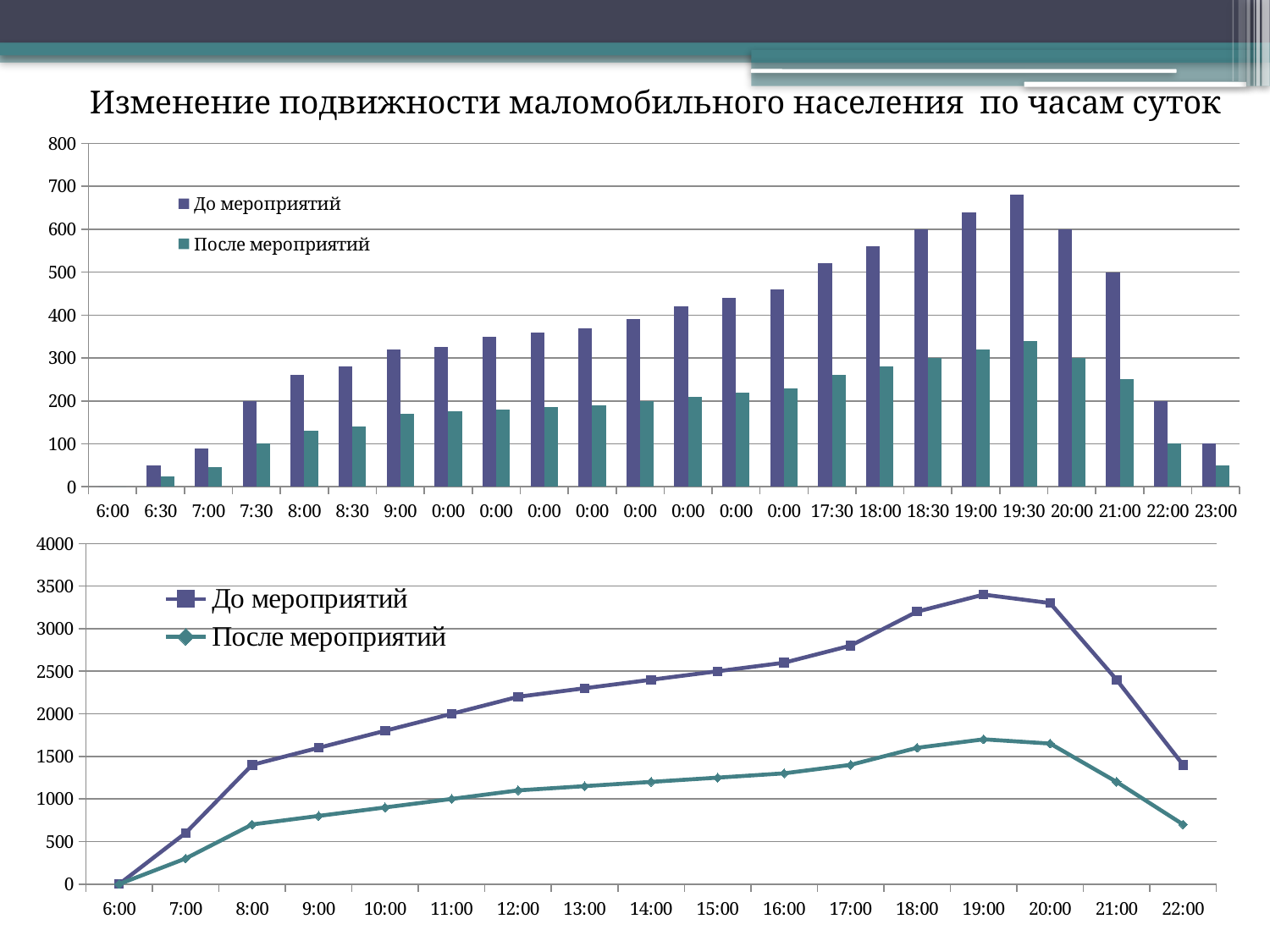
In the top bar chart, how many series does the legend list? 2 In the top bar chart, at which time is the 'После мероприятий' bar highest? 19:30 In the bottom line chart, which series has the larger value at 8:00, 'До мероприятий' or 'После мероприятий'? До мероприятий In the top bar chart, at which time is the 'До мероприятий' bar highest? 19:30 What kind of chart is the bottom chart on the slide? line chart In the top bar chart, is the 'До мероприятий' value at 19:30 greater or less than 600? greater In the bottom line chart, is the 'После мероприятий' value at 22:00 greater or less than 1000? less In the bottom line chart, how many time points are plotted along the x axis? 17 In the bottom line chart, is the 'До мероприятий' value at 19:00 greater or less than 3000? greater What kind of chart is the top chart on the slide? bar chart In the bottom line chart, at which time does the 'До мероприятий' line reach its highest point? 19:00